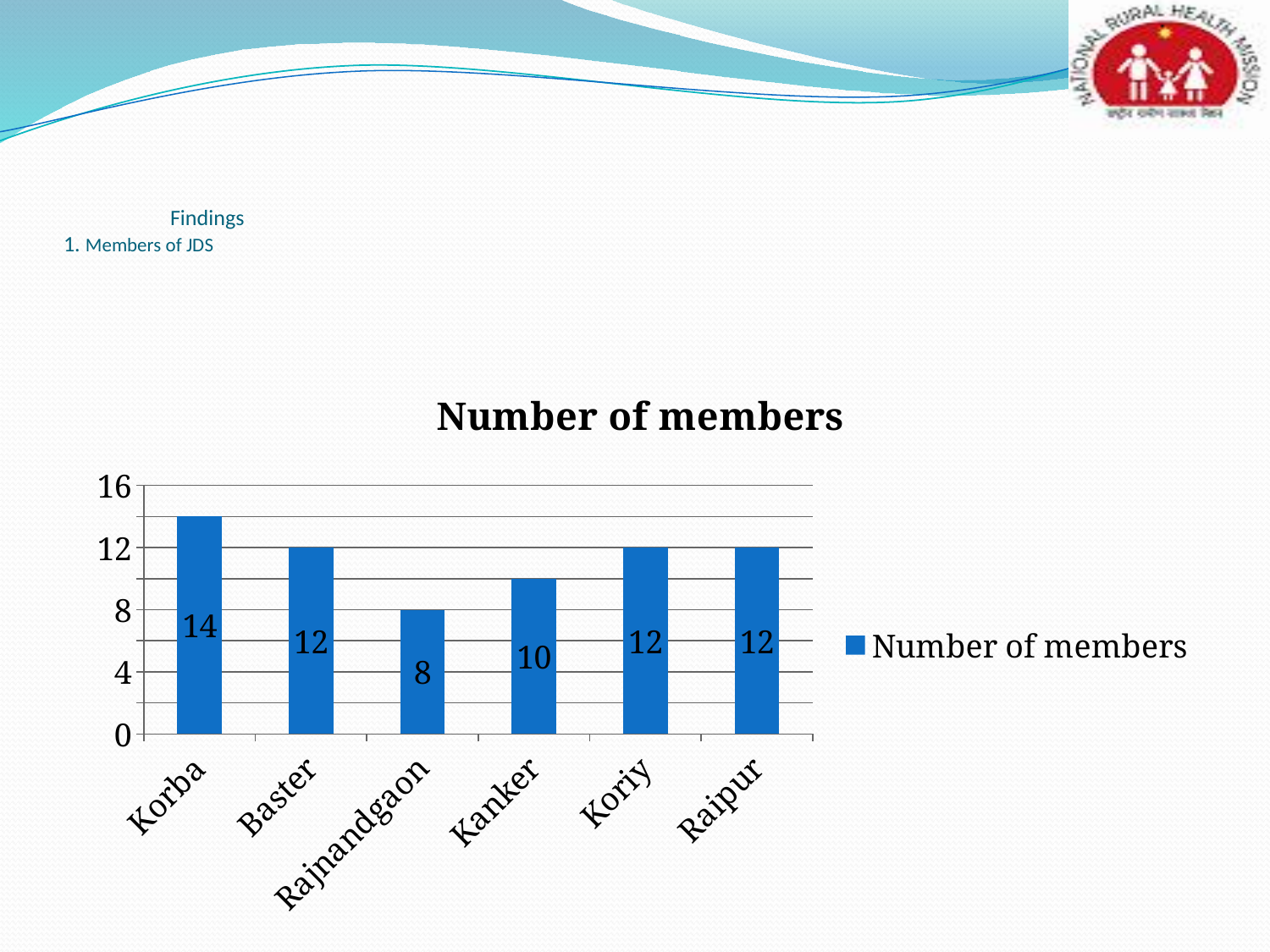
How many categories are shown on the x axis? 6 What kind of chart is shown on the slide? bar chart Is the value for Baster greater or less than 8? greater Which has more members, Kanker or Koriy? Koriy What is the title of the chart? Number of members What is the difference between the number of members for Korba and Rajnandgaon? 6 Which category has the highest number of members? Korba Which category has the lowest number of members? Rajnandgaon How many series does the legend list? 1 What is the number of members for Korba? 14 What is the number of members for Kanker? 10 What is the number of members for Rajnandgaon? 8